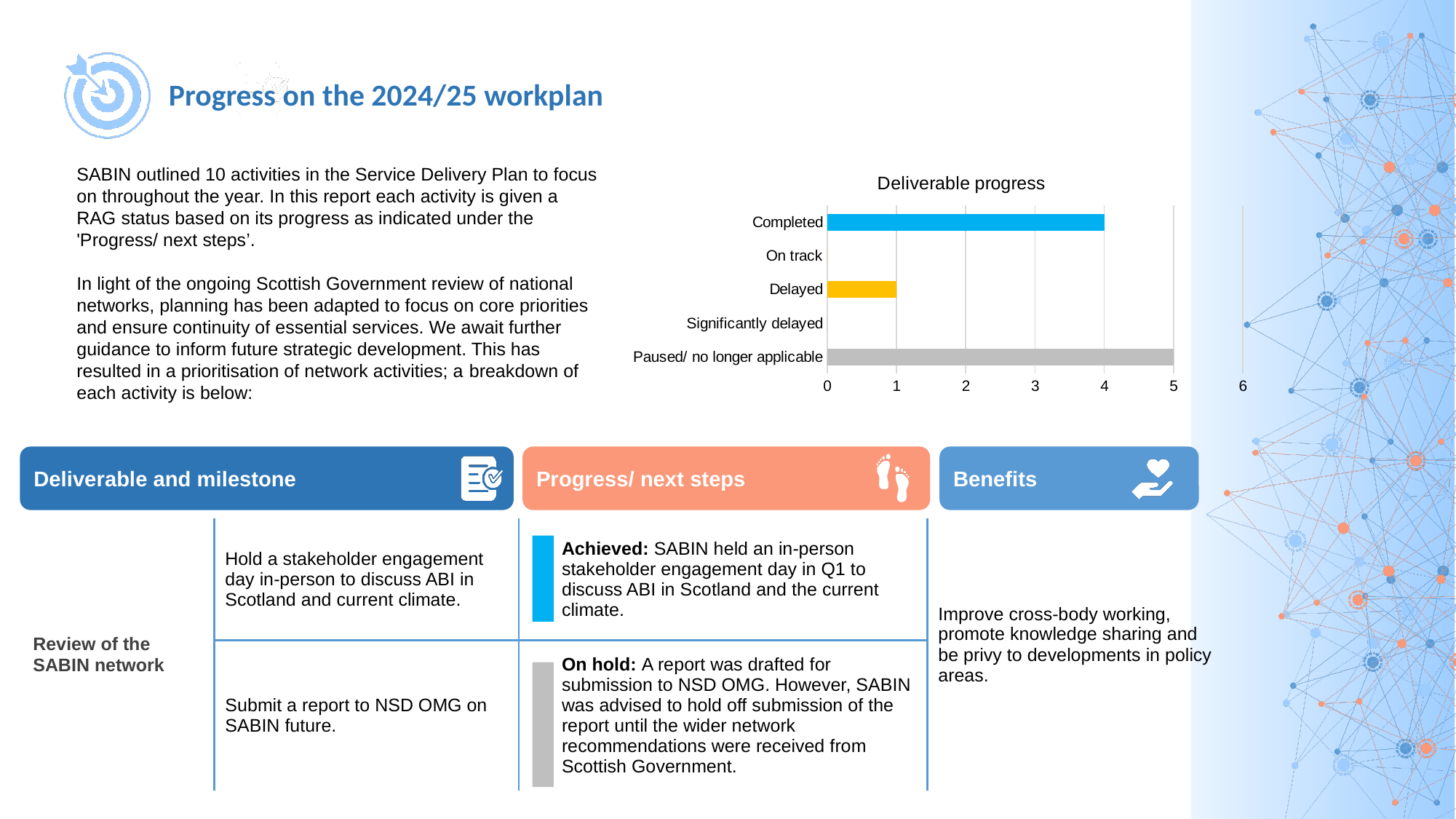
What colour is the bar for Delayed? yellow Is the value for Completed greater or less than 3? greater What is the title of the chart on the slide? Deliverable progress What is the value for Paused/ no longer applicable? 5 What kind of chart is shown on the slide? bar chart What is the value for Delayed? 1 What is the difference between the values for Completed and Delayed? 3 Which category has the highest value? Paused/ no longer applicable What is the difference between the values for Paused/ no longer applicable and Completed? 1 How many categories are shown on the chart? 5 Which has the larger value, Completed or Delayed? Completed What is the value for Completed? 4